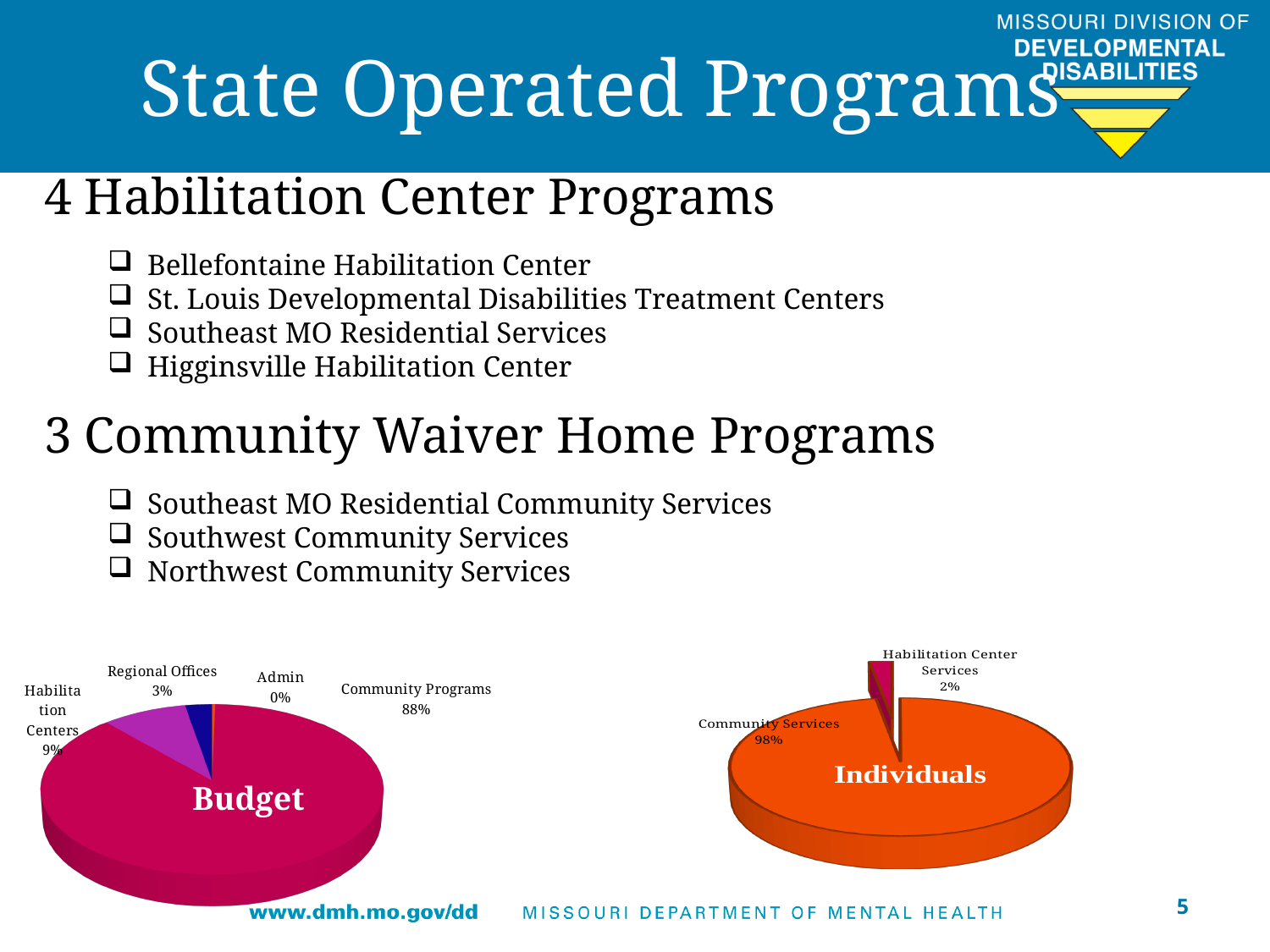
What kind of chart is the Budget chart on the left? pie chart In the Budget pie chart, what share does Habilitation Centers have? 9% In the Budget pie chart, what share does Admin have? 0% In the Budget pie chart, what is the difference between the Community Programs share and the Habilitation Centers share? 79% In the Budget pie chart, what share does Regional Offices have? 3% In the Budget pie chart, how many categories are shown? 4 In the Individuals pie chart on the right, which is larger, Community Services or Habilitation Center Services? Community Services In the Budget pie chart, what share does Community Programs have? 88% In the Budget pie chart, which category has the largest share? Community Programs In the Individuals pie chart on the right, what share does Habilitation Center Services have? 2% In the Budget pie chart, which category has the smallest share? Admin In the Individuals pie chart on the right, what share does Community Services have? 98%